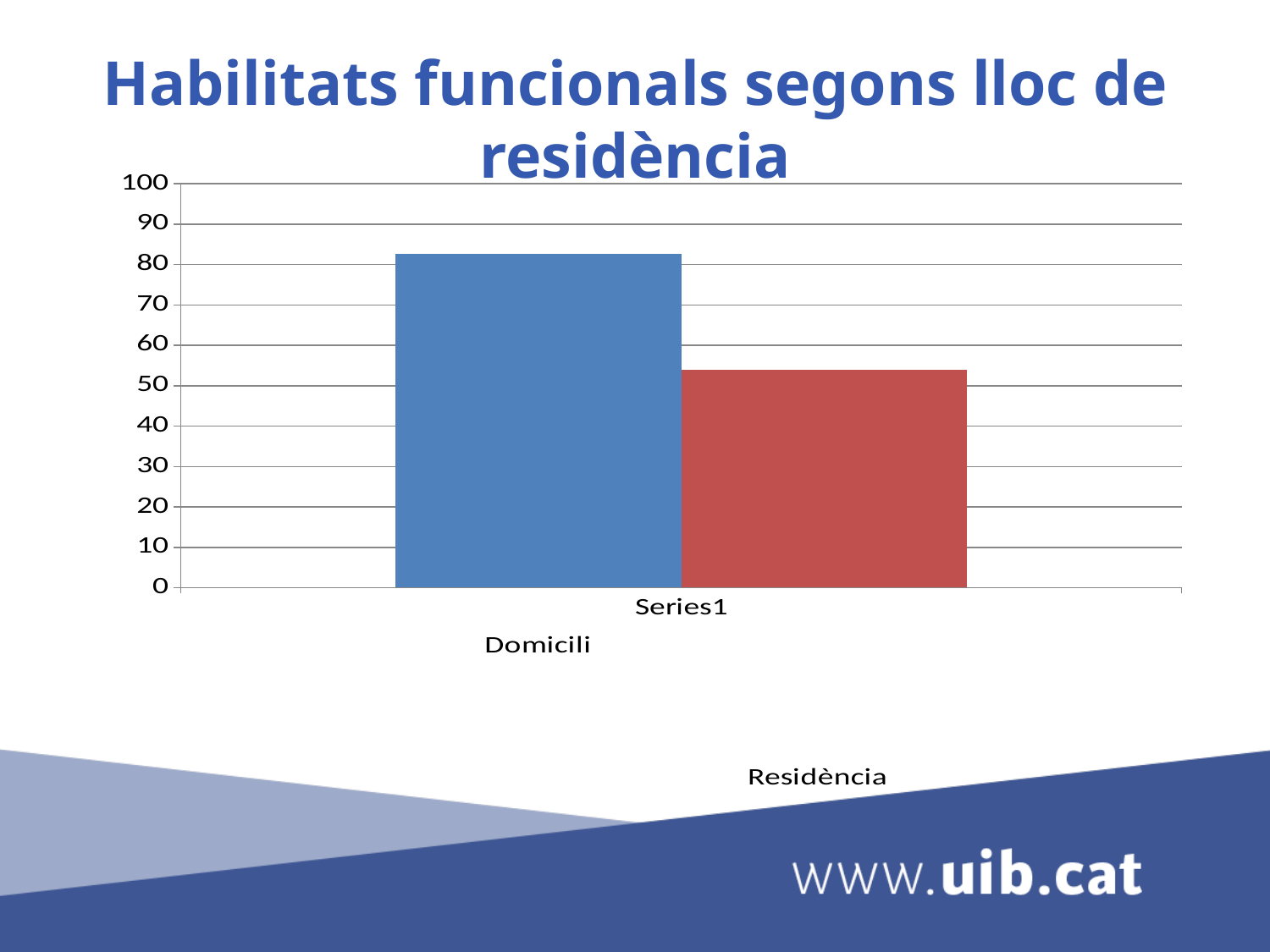
Which category has the lowest value? Residència What kind of chart is shown on the slide? bar chart Is the value for Domicili greater or less than 90? less Is the value for Domicili greater or less than 70? greater What is the title of the chart? Habilitats funcionals segons lloc de residència Is the value for Residència greater or less than 40? greater What is the highest value shown on the vertical axis? 100 Which bar is taller, Domicili or Residència? Domicili Which category has the highest value? Domicili What colour is the bar for Domicili? blue How many bars are plotted in the chart? 2